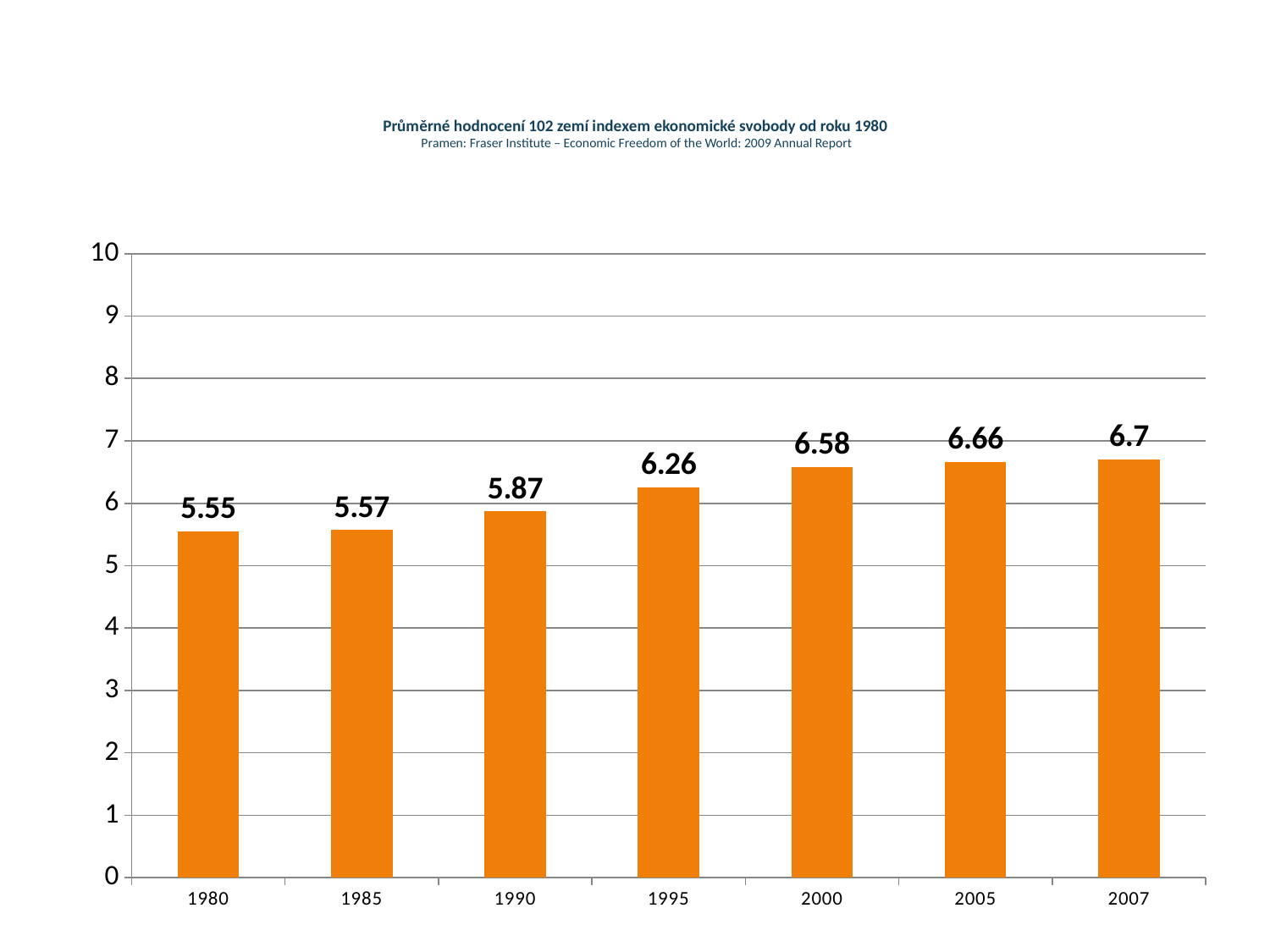
What kind of chart is shown on the slide? bar chart What is the difference between the values for 2007 and 1980? 1.15 What is the difference between the values for 2000 and 1990? 0.71 Which year has the lowest value? 1980 What is the value for 2007? 6.7 Is the value for 2000 greater or less than 6? greater What is the value for 1980? 5.55 How many years are shown on the x axis? 7 Which is larger, the value for 1990 or the value for 2005? 2005 Which year has the highest value? 2007 What is the value for 1995? 6.26 Do the values rise or fall from 1980 to 2007? rise